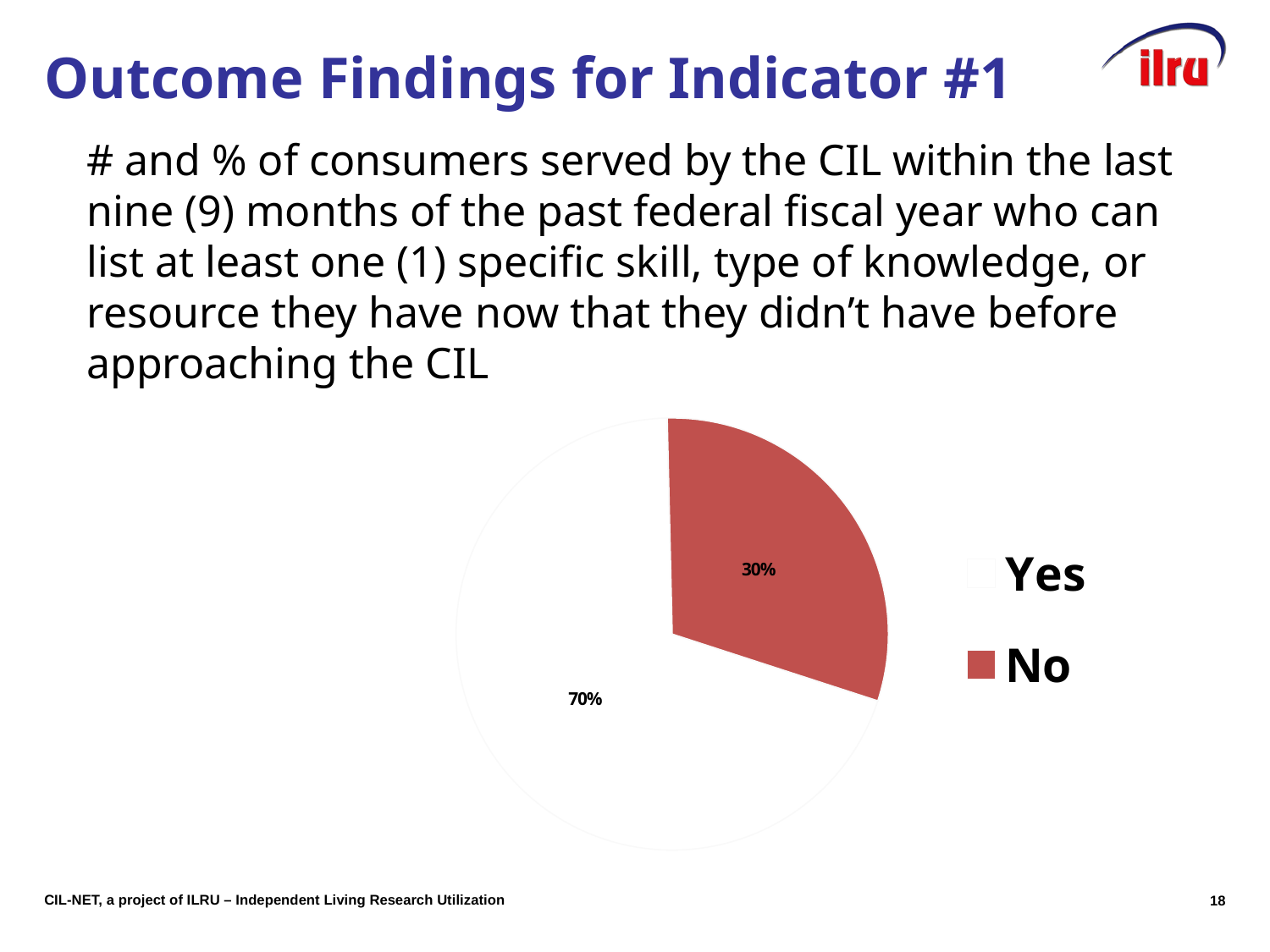
What share of the pie does the No slice represent? 30% What are the two legend entries of the pie chart? Yes and No Which slice of the pie is the smallest? No How many entries does the legend list? 2 What colour is the No slice in the pie chart? red What percentage of the pie is labelled for the Yes slice? 70% How many slices does the pie chart have? 2 Which is larger, the Yes slice or the No slice? Yes What kind of chart is shown on the slide? pie chart What is the difference in percentage points between the Yes and No slices? 40 What percentage of the pie is labelled for the No slice? 30% Which slice of the pie is the largest? Yes